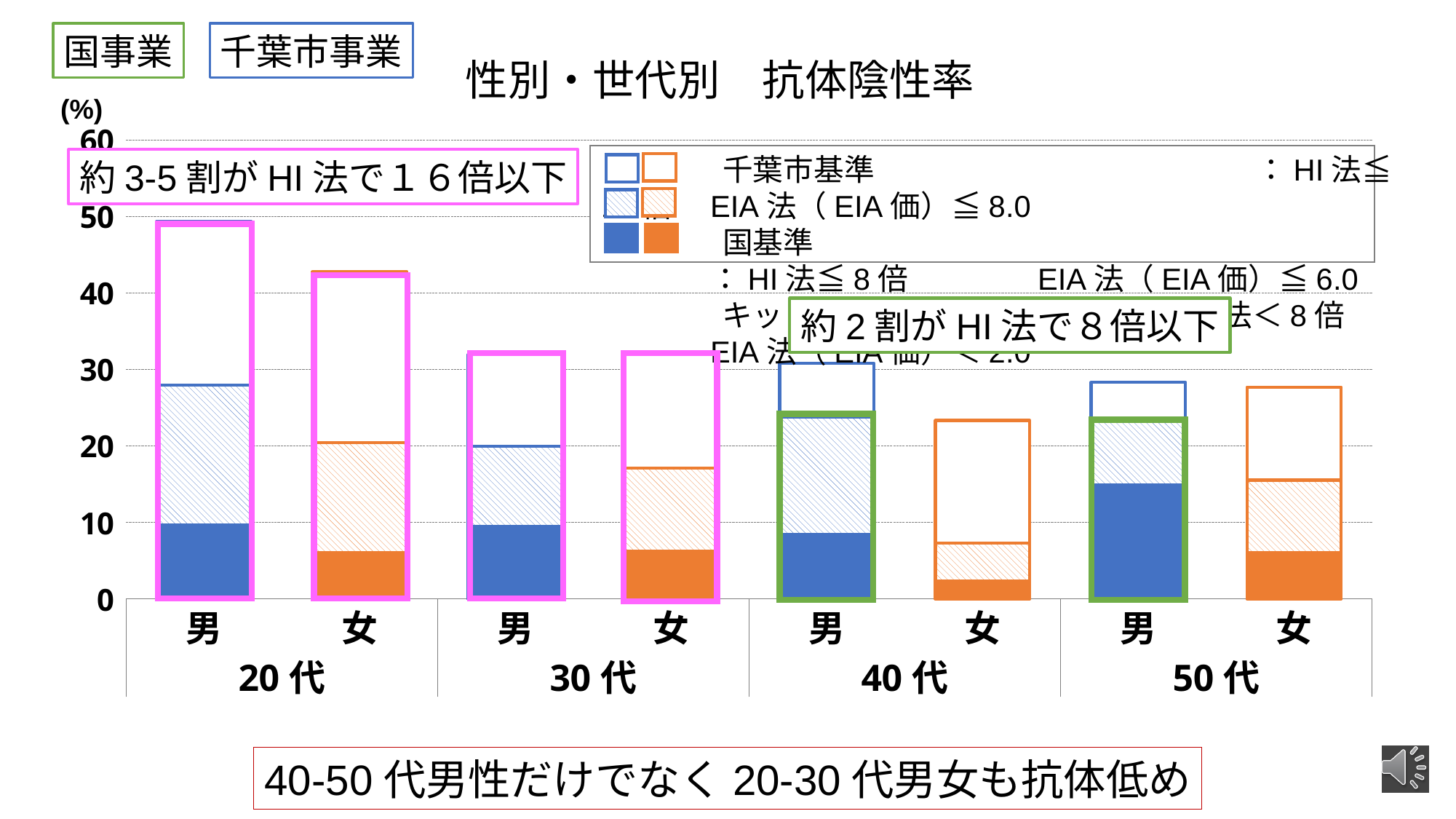
How many bars are plotted in the chart? 8 What is the title of the chart? 性別・世代別 抗体陰性率 What unit is shown on the y axis? % Is the total value for 20代 男 greater or less than 40? greater Which has the larger total value, 20代 男 or 20代 女? 20代 男 Is the solid (国基準) portion of the 40代 女 bar greater or less than 10? less Is the total value for 40代 女 greater or less than 30? less Which bar has the lowest total value? 40代 女 Which bar has the highest total value? 20代 男 Do the total values for 男 rise or fall from 20代 to 50代? fall What kind of chart is shown on the slide? bar chart